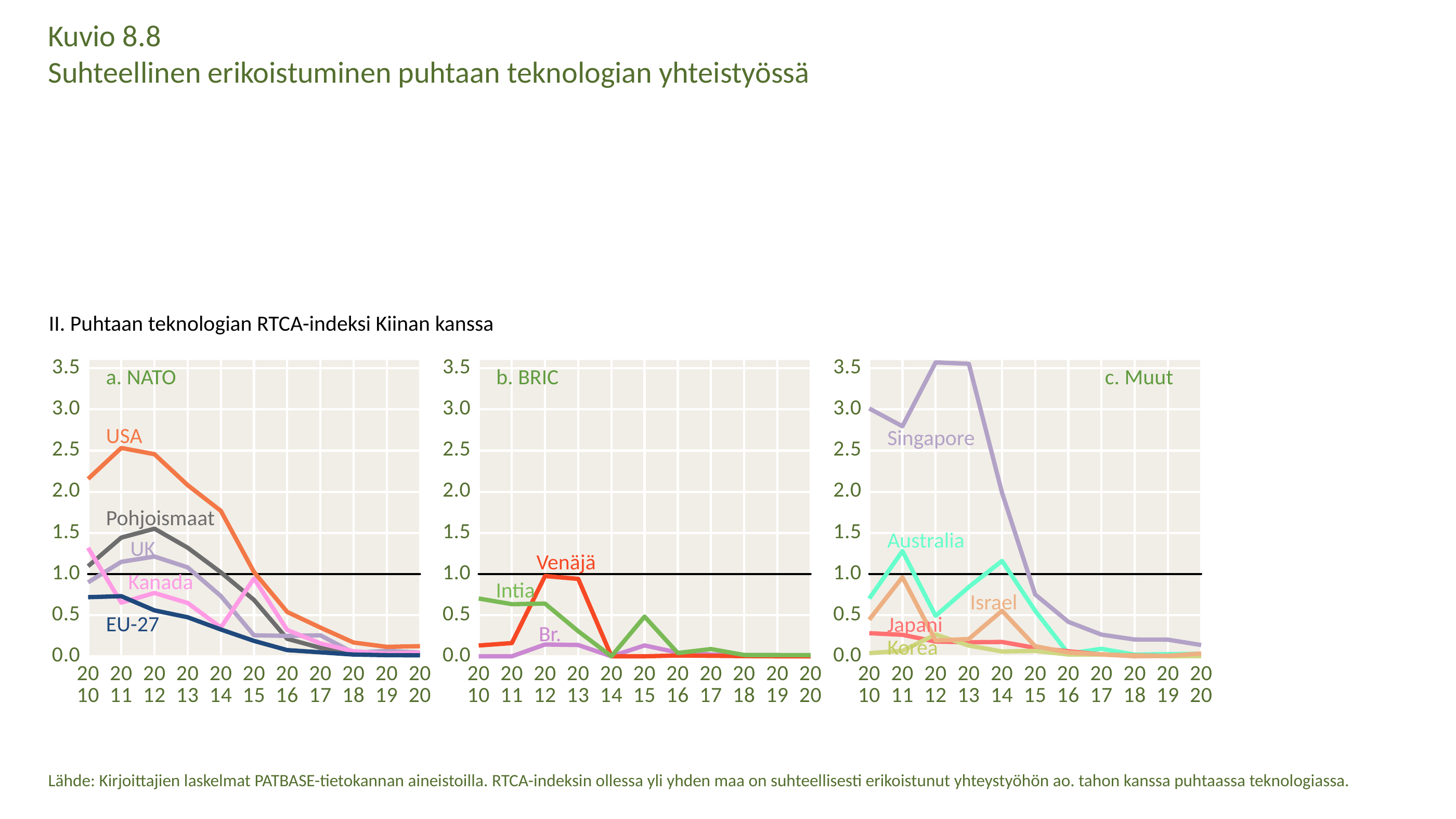
In the 'a. NATO' chart, how many series are labelled? 5 In the 'a. NATO' chart, how many years are shown on the x axis? 11 In the 'b. BRIC' chart, is the value for Intia in 2010 greater or less than 0.5? greater In the 'c. Muut' chart, which is larger in 2011: Singapore or Australia? Singapore In the 'a. NATO' chart, is the value for EU-27 in 2010 greater or less than 1.0? less What kind of chart is the 'a. NATO' chart? line chart In the 'c. Muut' chart, which series has the highest value in 2012? Singapore In the 'a. NATO' chart, which series has the highest value in 2011? USA In the 'a. NATO' chart, is the value for USA in 2011 greater or less than 2.0? greater In the 'a. NATO' chart, does the USA series overall rise or fall from 2012 to 2020? fall In the 'b. BRIC' chart, how many series are labelled? 3